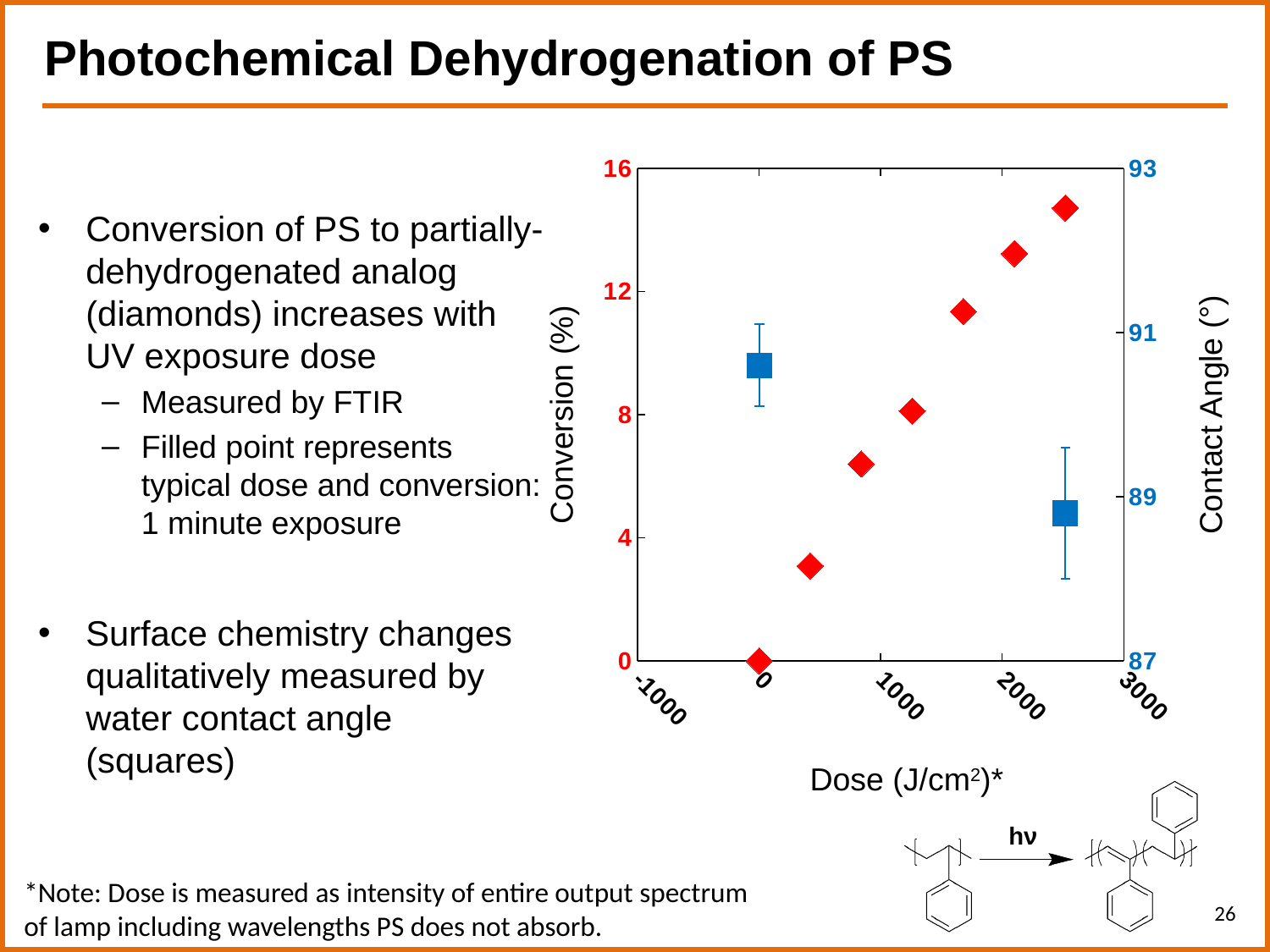
How many red diamond (conversion) points are plotted? 7 What is the label of the right vertical axis? Contact Angle (°) What is the highest tick value shown on the x axis? 3000 Is the contact angle of the square point at dose 0 greater or less than 89? greater Do the conversion (diamond) values rise or fall as dose increases? rise What kind of chart is shown on the slide? scatter chart Is the contact angle of the square point near dose 2500 greater or less than 91? less What is the label of the left vertical axis? Conversion (%) Is the conversion value of the highest diamond point greater or less than 12? greater How many blue square (contact angle) points are plotted? 2 Do the contact angle (square) values rise or fall as dose increases? fall Which diamond point has the higher conversion: the one near dose 400 or the one near dose 2500? the one near dose 2500